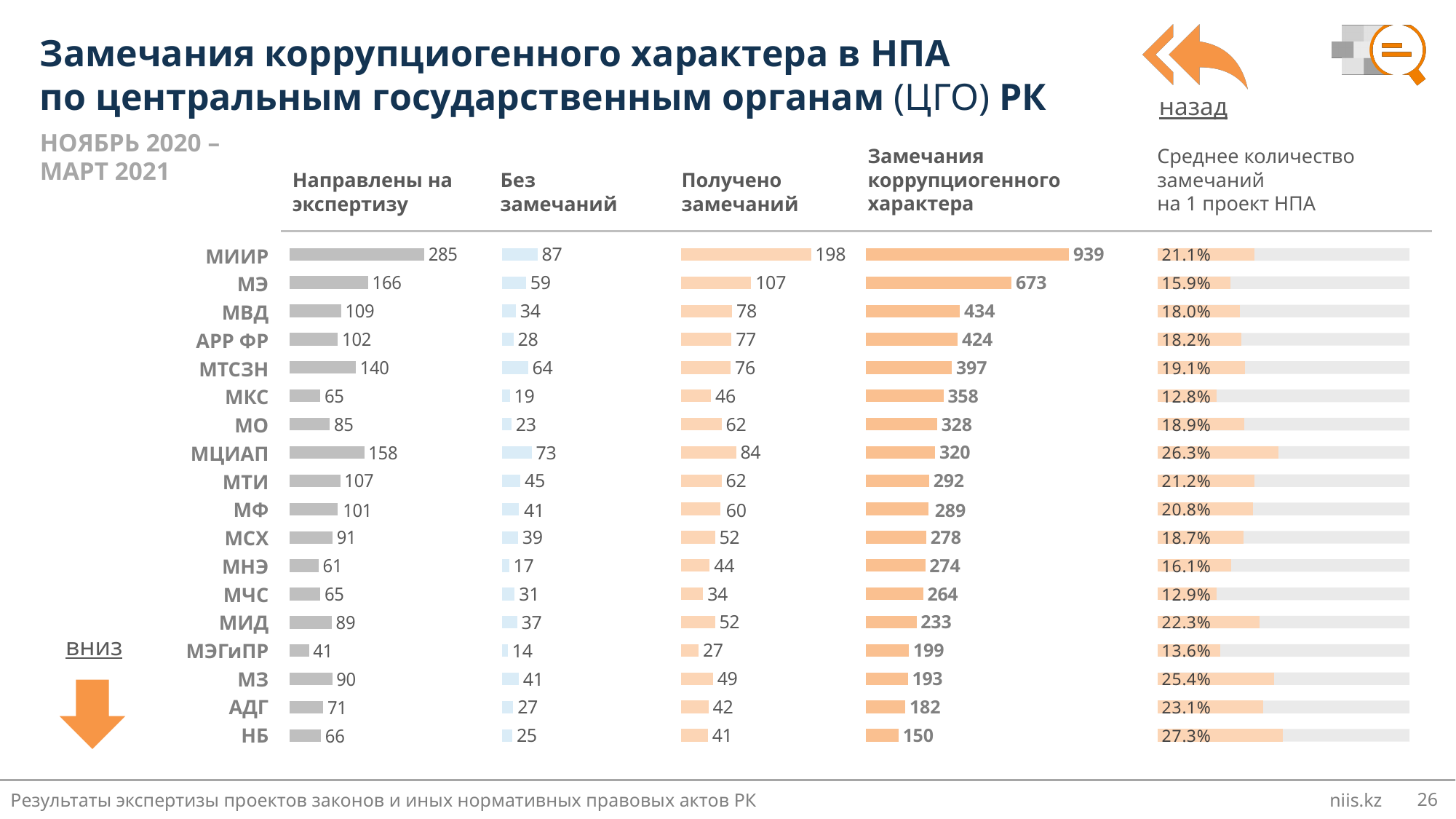
In the "Получено замечаний" chart, which organ has the highest value? МИИР In the "Замечания коррупциогенного характера" chart, what is the difference between МИИР and МЭ? 266 What kind of chart is used in the "Замечания коррупциогенного характера" column? Bar chart How many organs (categories) are listed in the charts on this slide? 18 In the "Без замечаний" chart, what is the value for МЭГиПР? 14 In the "Замечания коррупциогенного характера" chart, what is the value for МИИР? 939 In the "Направлены на экспертизу" chart, which is larger, МЭ or МЦИАП? МЭ In the "Направлены на экспертизу" chart, what is the value for МТСЗН? 140 Do the values in the "Замечания коррупциогенного характера" chart rise or fall going down the list from МИИР to НБ? Fall In the "Среднее количество замечаний на 1 проект НПА" chart, which organ has the highest value? НБ In the "Среднее количество замечаний на 1 проект НПА" chart, what is the value for МЦИАП? 26.3% In the "Замечания коррупциогенного характера" chart, which organ has the lowest value? НБ